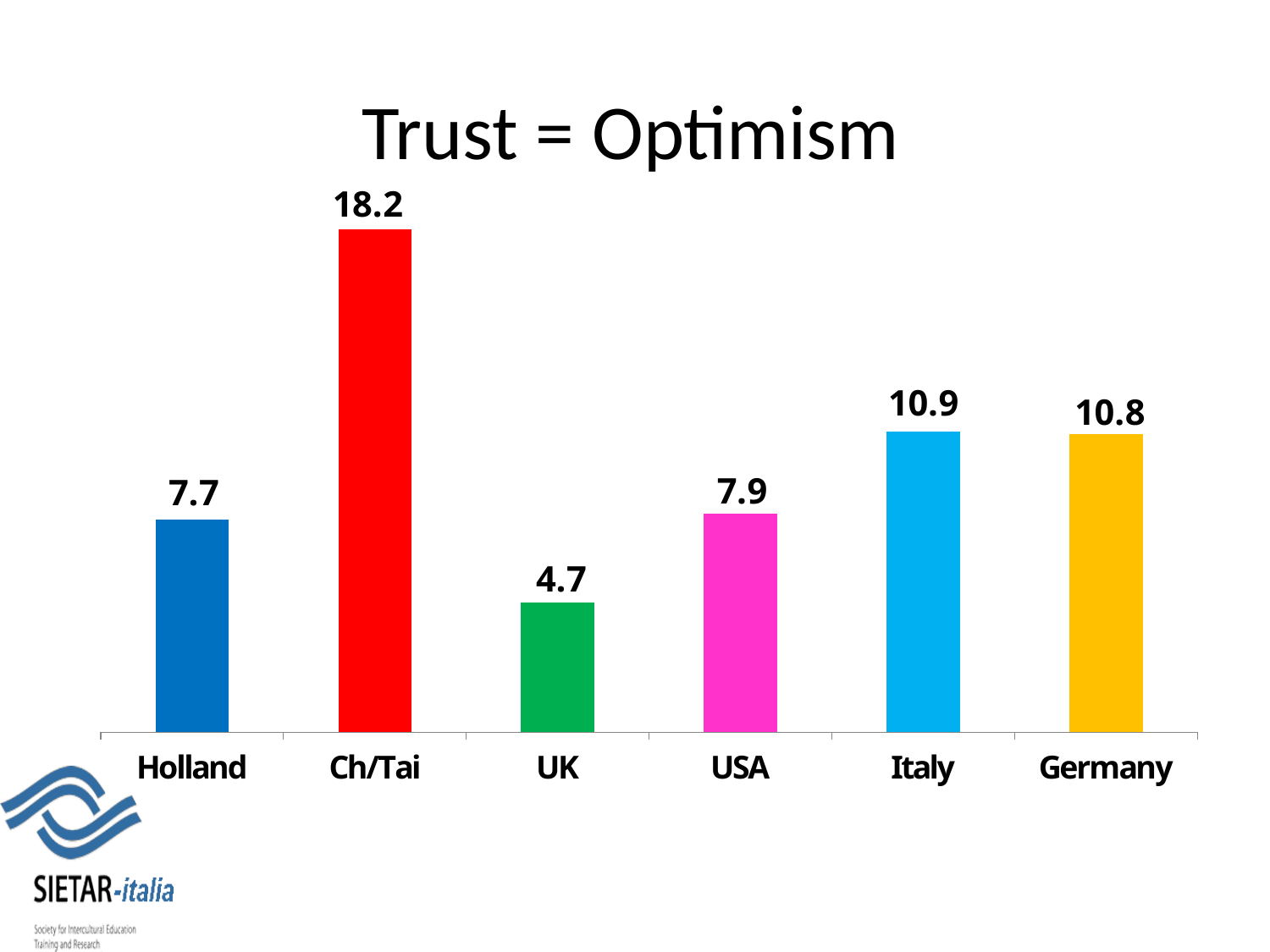
What is the value for Germany? 10.8 What is the title of the chart? Trust = Optimism Which is larger, the value for USA or the value for Holland? USA What is the value for Holland? 7.7 What kind of chart is shown on the slide? Bar chart Which category has the lowest value? UK Which category has the highest value? Ch/Tai How many categories are shown in the chart? 6 What is the difference between the values for Ch/Tai and UK? 13.5 What is the difference between the values for Italy and Germany? 0.1 Which is larger, the value for Italy or the value for UK? Italy What is the value for Ch/Tai? 18.2